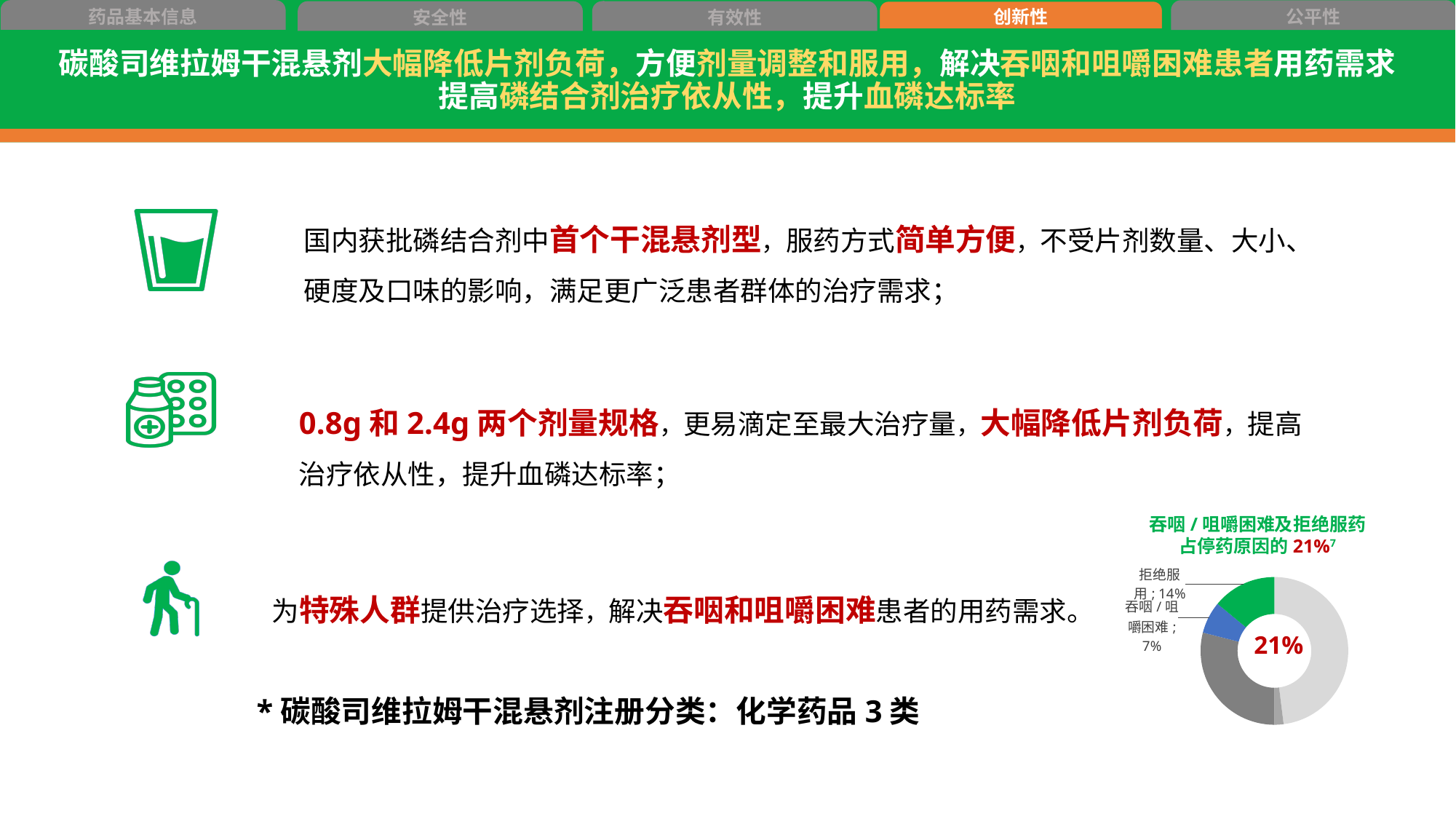
What is the title of the donut chart at the bottom right? 吞咽/咀嚼困难及拒绝服药占停药原因的 21% In the donut chart at the bottom right, which is larger: the share for 拒绝服用 or the share for 吞咽/咀嚼困难? 拒绝服用 What value is printed in the centre of the donut chart at the bottom right? 21% In the donut chart at the bottom right, what percentage is shown for 拒绝服用? 14% In the donut chart at the bottom right, what is the difference between the share for 拒绝服用 and the share for 吞咽/咀嚼困难? 7% In the donut chart at the bottom right, what colour is the slice for 拒绝服用? Green In the donut chart at the bottom right, what is the combined share of 拒绝服用 and 吞咽/咀嚼困难? 21% How many slices does the donut chart at the bottom right have? 5 In the donut chart at the bottom right, what percentage is shown for 吞咽/咀嚼困难? 7% What kind of chart is shown at the bottom right of the slide? Pie (donut) chart